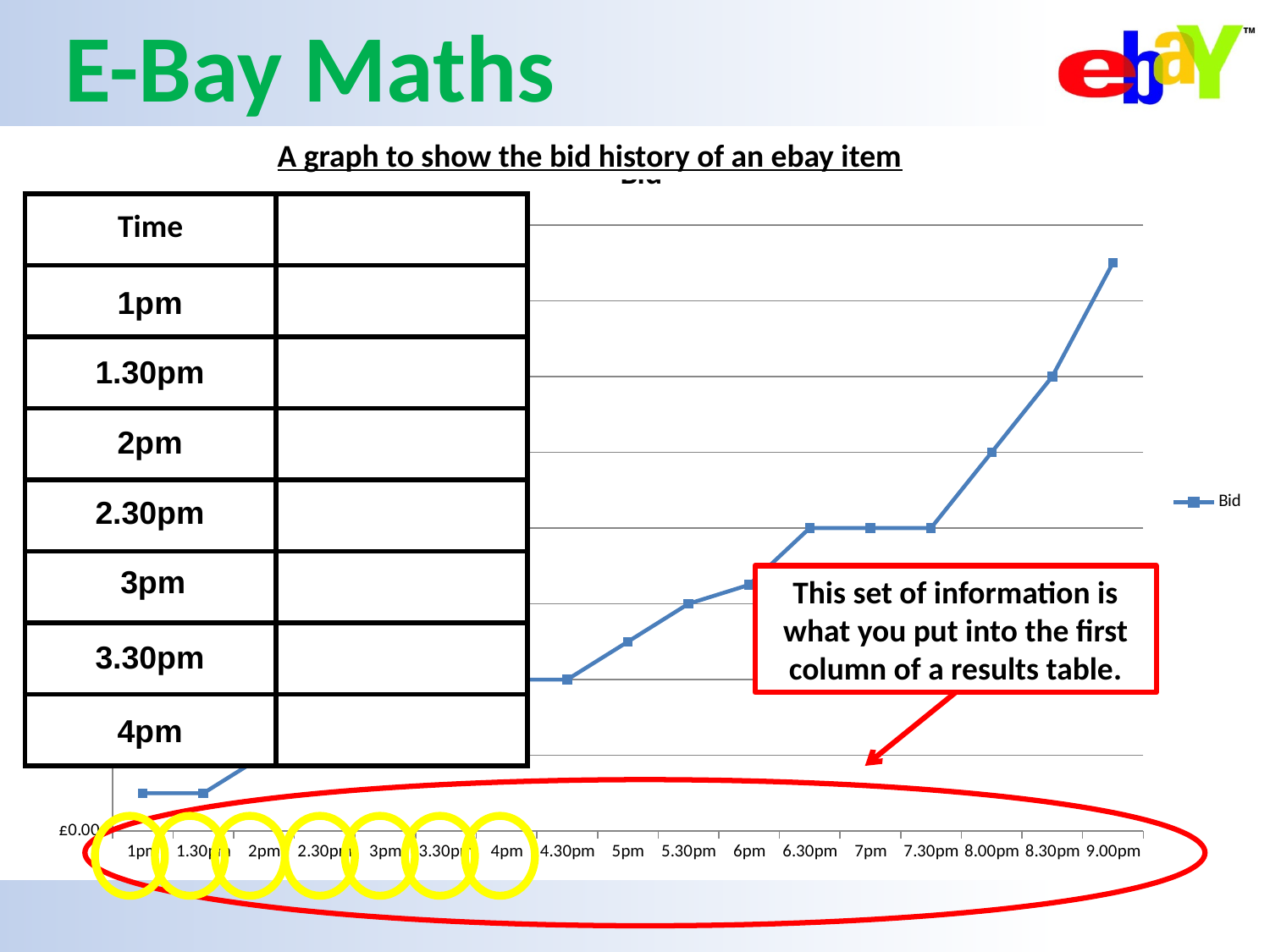
At which time is the bid value highest? 9.00pm What is the name of the series shown in the chart's legend? Bid How many time points are labelled along the x axis of the chart? 17 Which has the larger bid value, 4.30pm or 5pm? 5pm Which has the larger bid value, 7.30pm or 8.30pm? 8.30pm Which has the larger bid value, 6.30pm or 9.00pm? 9.00pm What kind of chart is shown on the slide? line chart What is the first time label on the x axis of the chart? 1pm How many series does the chart's legend list? 1 Overall, do the bid values rise or fall from 1pm to 9.00pm? rise